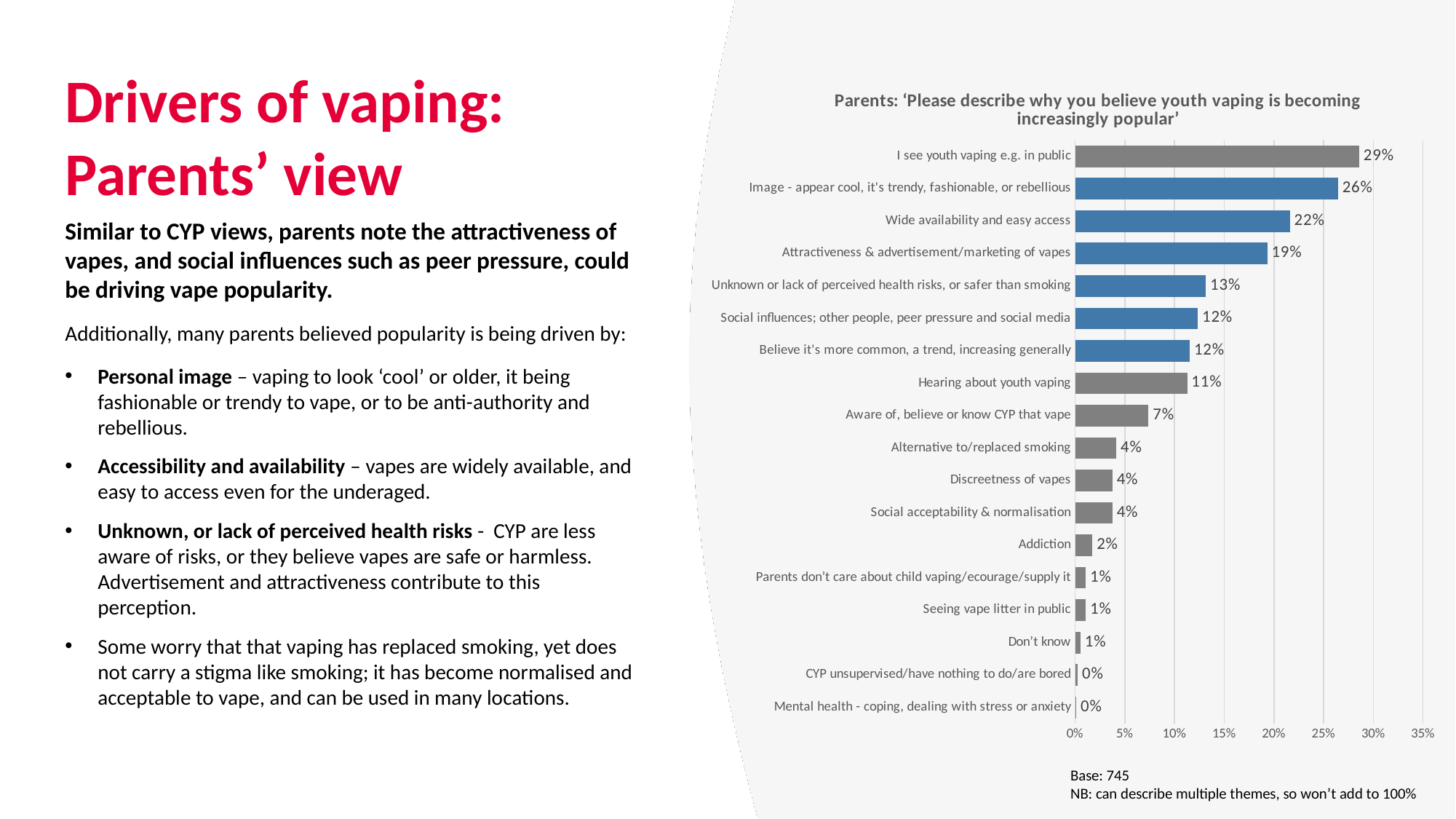
What is the value for 'Addiction'? 2% What is the difference between 'Image - appear cool, it's trendy, fashionable, or rebellious' and 'Attractiveness & advertisement/marketing of vapes'? 7% Is the value for 'Wide availability and easy access' greater or less than 20%? greater What is the lowest value shown in the chart? 0% What percentage of parents said 'I see youth vaping e.g. in public'? 29% Which category has the highest value in the chart? I see youth vaping e.g. in public How many categories are shown in the chart? 18 What is the value for 'Wide availability and easy access'? 22% What percentage is shown for 'Unknown or lack of perceived health risks, or safer than smoking'? 13% What is the base (number of respondents) stated below the chart? 745 What kind of chart is shown on the slide? Bar chart Which is larger: 'Hearing about youth vaping' or 'Aware of, believe or know CYP that vape'? Hearing about youth vaping